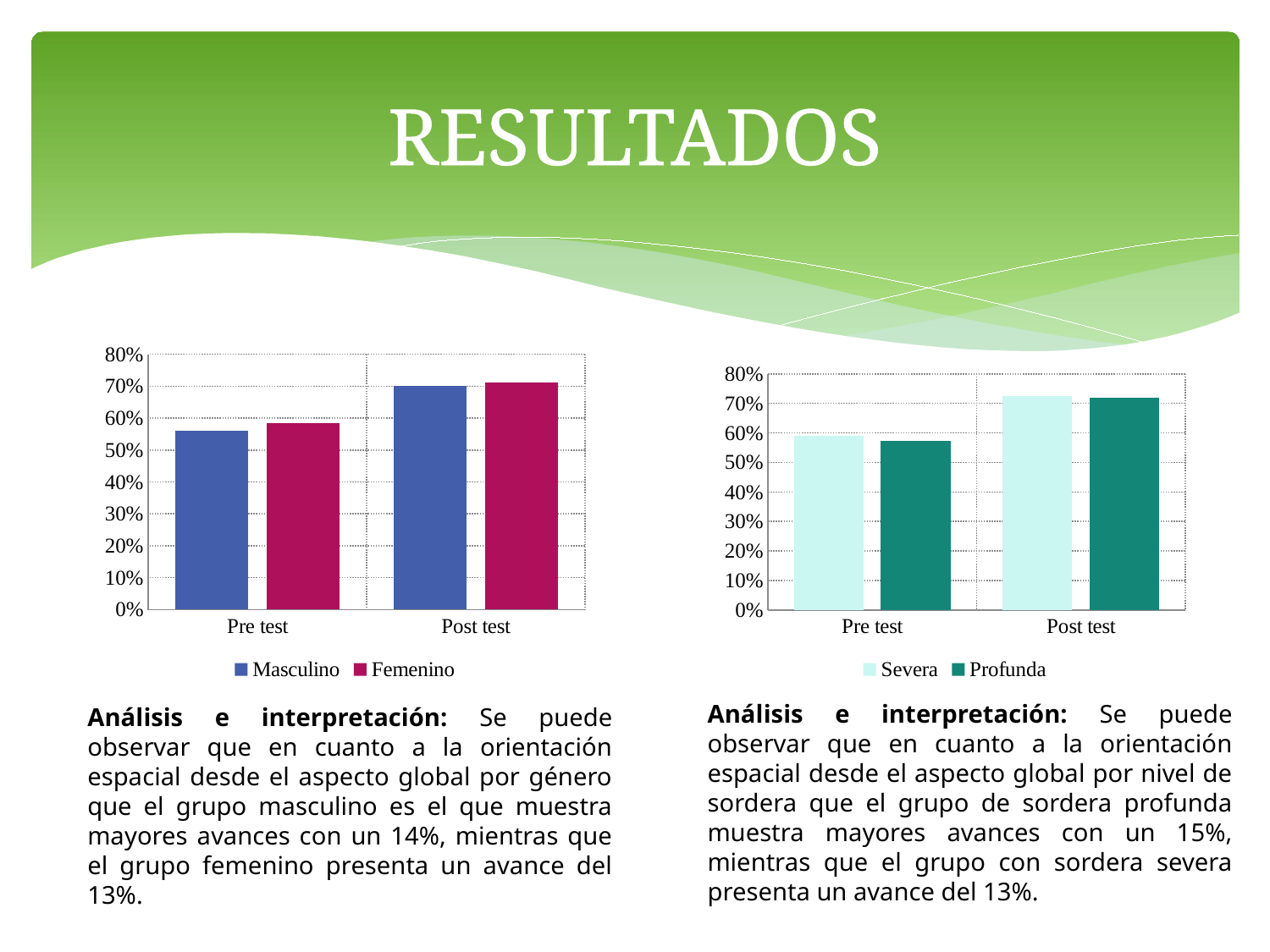
How many series does the legend of the left chart list? 2 What is the highest value shown on the y axis of the right chart? 80% What kind of chart is the left chart on the slide? bar chart In the right chart, is the Profunda value for Post test greater or less than 60%? greater In the left chart, which is larger for Masculino: Pre test or Post test? Post test In the left chart, is the Masculino value for Post test greater or less than 60%? greater In the right chart, is the Profunda value for Pre test greater or less than 60%? less In the left chart, do the Femenino values rise or fall from Pre test to Post test? rise What are the two series in the legend of the right chart? Severa and Profunda How many categories are shown on the x axis of the right chart? 2 In the right chart, which is larger for Severa: Pre test or Post test? Post test